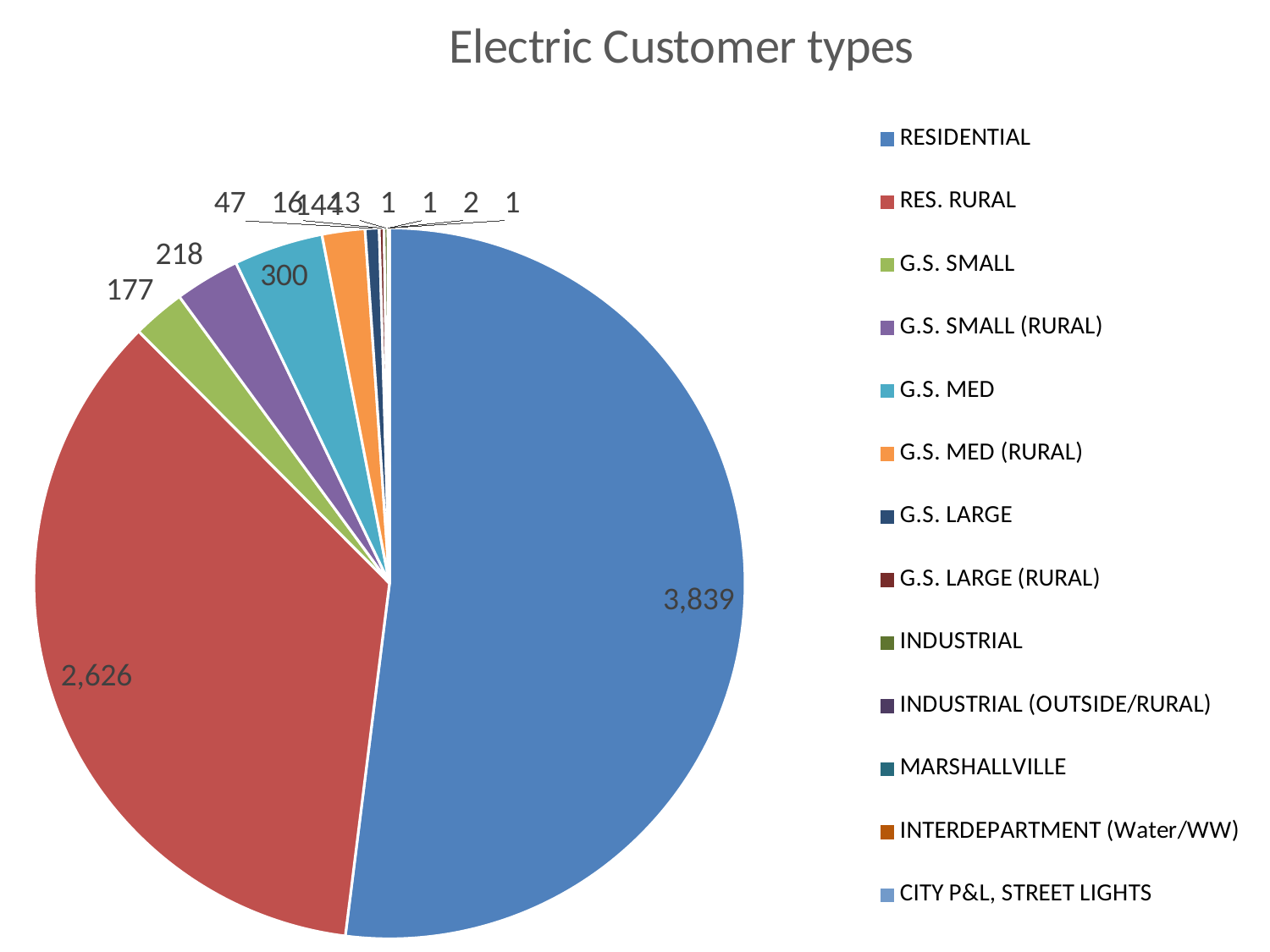
How many customer types does the legend list? 13 Which is larger, G.S. SMALL or G.S. SMALL (RURAL)? G.S. SMALL (RURAL) What is the value for RES. RURAL? 2,626 Which customer type has the largest slice? RESIDENTIAL What is the value for G.S. SMALL? 177 What is the value for G.S. SMALL (RURAL)? 218 What type of chart is shown on the slide? pie chart What is the title of the chart? Electric Customer types What is the difference between the RESIDENTIAL and RES. RURAL values? 1,213 What is the difference between the G.S. MED and G.S. SMALL (RURAL) values? 82 What is the value for G.S. MED? 300 What is the value for RESIDENTIAL? 3,839